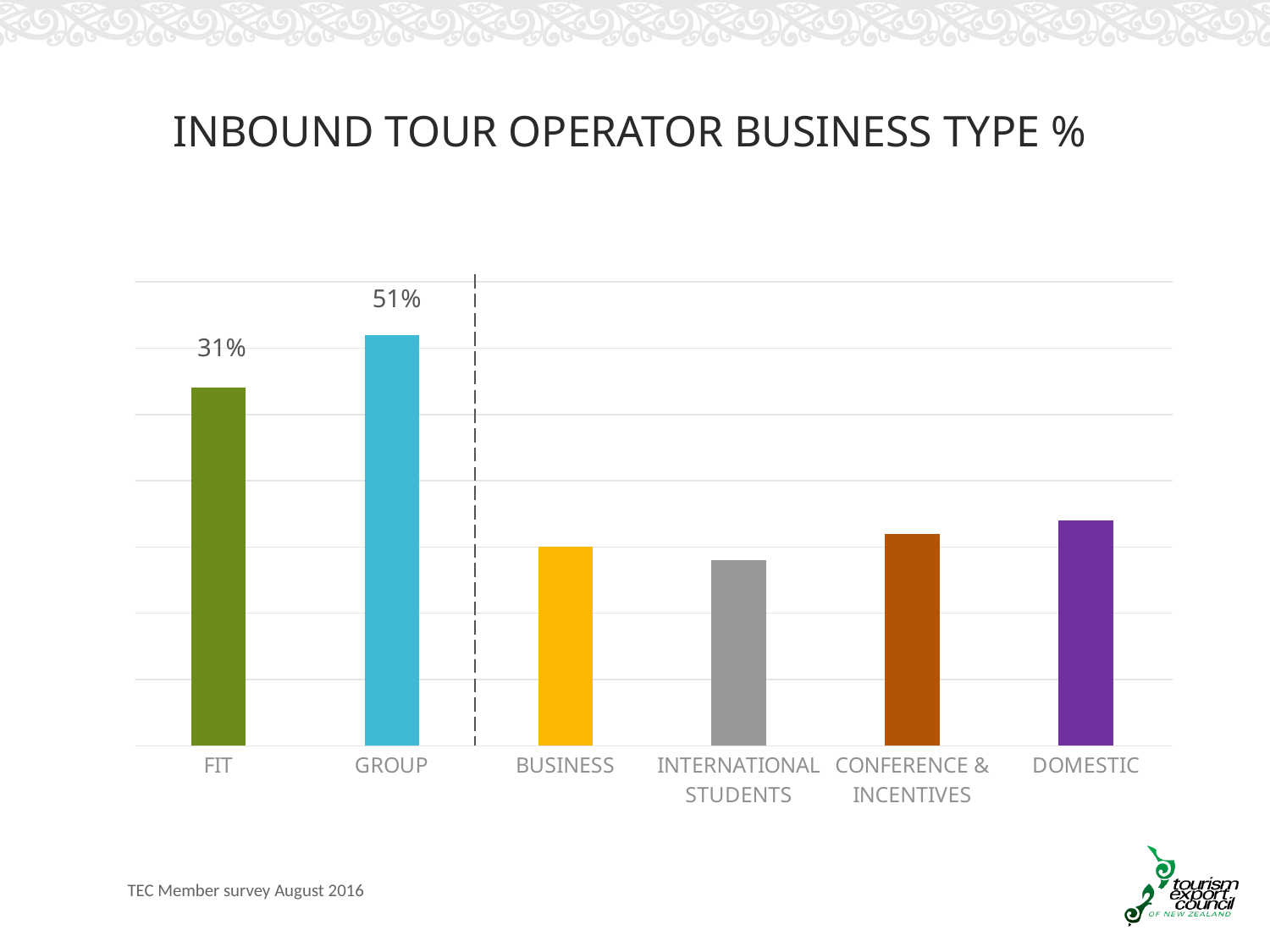
Which business type has the lowest value? INTERNATIONAL STUDENTS How many business types are shown on the chart? 6 Which business type has the highest value? GROUP What is the title of the chart? INBOUND TOUR OPERATOR BUSINESS TYPE % Which is larger, the value for DOMESTIC or the value for INTERNATIONAL STUDENTS? DOMESTIC What is the difference between the GROUP and FIT values? 20% What kind of chart is shown on the slide? Bar chart What is the value for GROUP? 51% What colour is the GROUP bar? Blue What is the value for FIT? 31% Which is larger, the value for FIT or the value for DOMESTIC? FIT